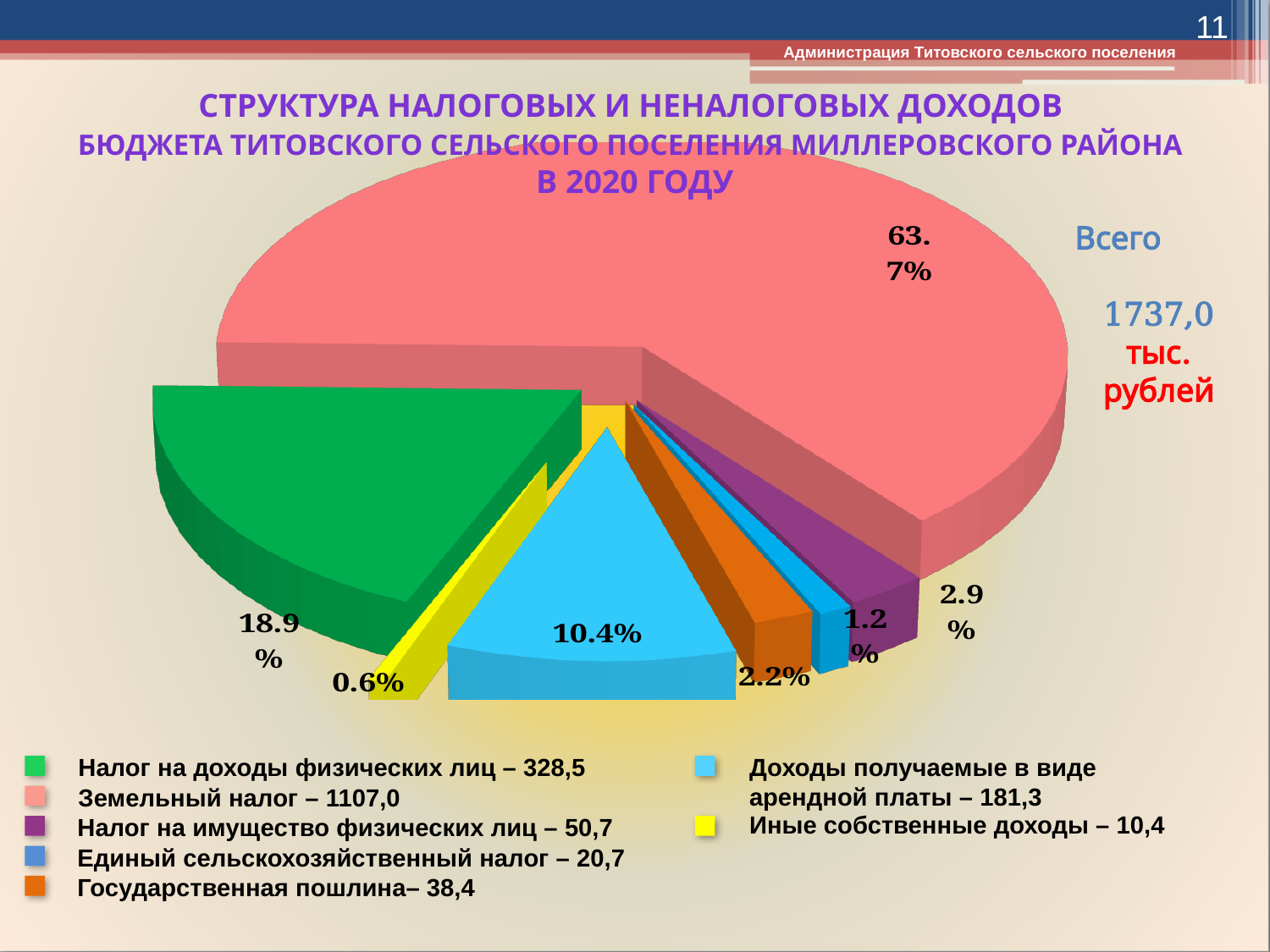
What total amount (Всего) is stated next to the pie chart? 1737,0 тыс. рублей According to the legend, what is the value for Единый сельскохозяйственный налог? 20,7 What share of the pie does the Доходы получаемые в виде арендной платы slice (light blue) represent? 10.4% What share of the pie does the Земельный налог slice (pink) represent? 63.7% What share of the pie does the Налог на доходы физических лиц slice (green) represent? 18.9% Which is larger: the share for Налог на имущество физических лиц or the share for Государственная пошлина? Налог на имущество физических лиц Which category has the smallest share of the pie? Иные собственные доходы According to the legend, what is the value for Государственная пошлина? 38,4 What type of chart is shown on the slide? pie chart How many slices does the pie chart have? 7 Which category has the largest share of the pie? Земельный налог